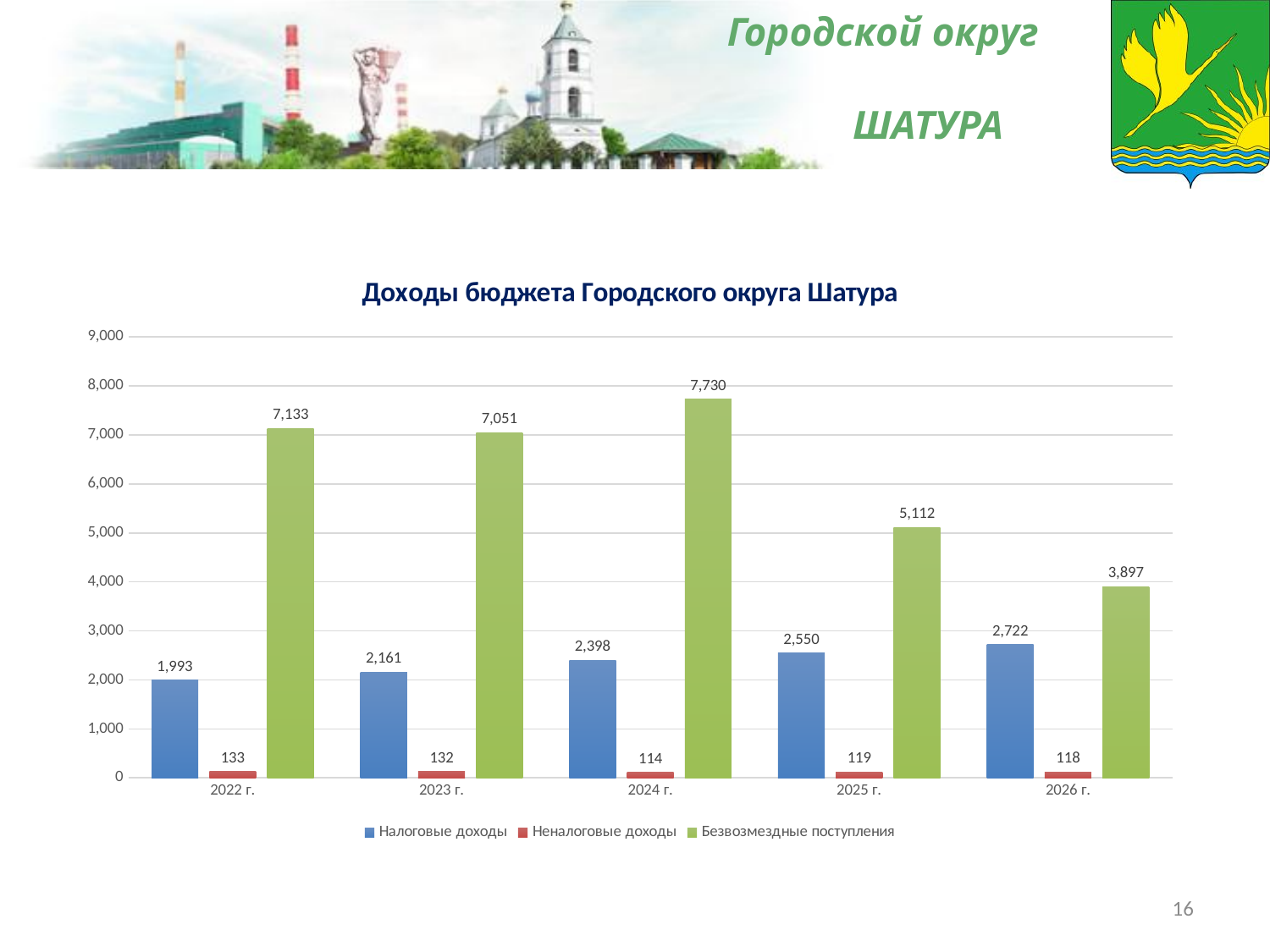
Do the values of Налоговые доходы rise or fall from 2022 г. to 2026 г.? Rise Which is larger: Налоговые доходы in 2026 г. or Безвозмездные поступления in 2026 г.? Безвозмездные поступления in 2026 г. How many years are shown on the x axis? 5 What is the value of Налоговые доходы for 2024 г.? 2,398 What kind of chart is this? Bar chart How many series does the legend list? 3 What is the value of Безвозмездные поступления for 2025 г.? 5,112 What is the difference between Безвозмездные поступления in 2024 г. and 2026 г.? 3,833 In which year is Безвозмездные поступления highest? 2024 г. In which year is Налоговые доходы lowest? 2022 г. What is the title of the chart? Доходы бюджета Городского округа Шатура What is the value of Неналоговые доходы for 2022 г.? 133